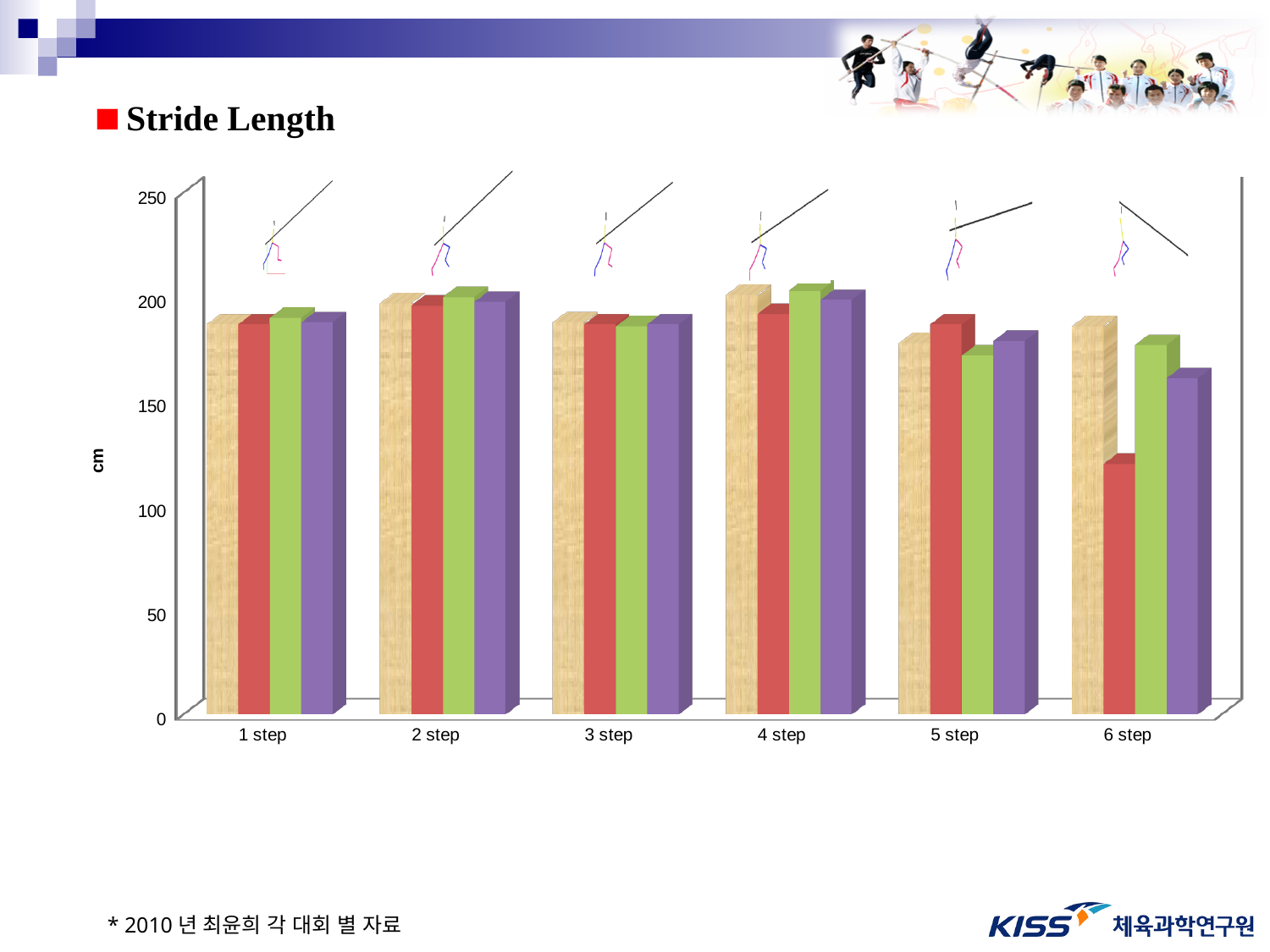
How many step categories are shown on the x axis of the chart? 6 Which is larger: the red bar at 1 step or the red bar at 6 step? 1 step What kind of chart is shown on the slide? bar chart What is the title of the chart? Stride Length Is the value of the first (tan) bar at 2 step greater or less than 150? greater At which step category is the red bar lowest? 6 step Which is larger: the tan bar at 6 step or the red bar at 6 step? tan bar Is the value of the green bar at 5 step greater or less than 150? greater Is the value of the purple bar at 6 step greater or less than 100? greater What unit is shown on the vertical axis label of the chart? cm How many bars are plotted for each step category? 4